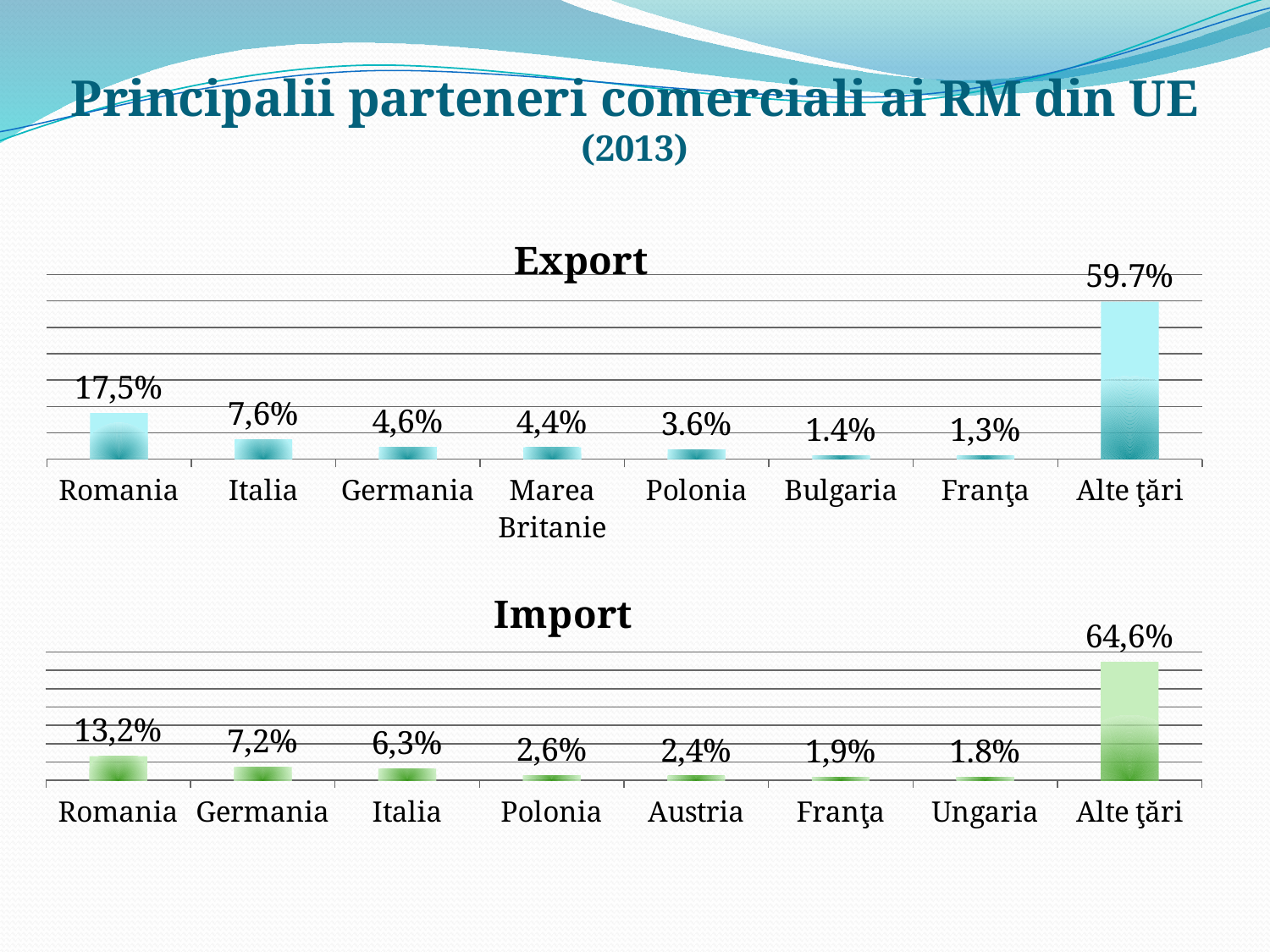
In the Import chart, what is the value for Ungaria? 1.8% In the Export chart, what is the difference between the values for Romania and Italia? 9,9% What kind of chart is the Export chart? Bar chart In the Import chart, which is larger, the value for Austria or the value for Franţa? Austria In the Import chart, what is the difference between the values for Italia and Polonia? 3,7% In the Export chart, what is the value for Alte ţări? 59.7% In the Export chart, what is the value for Polonia? 3.6% In the Import chart, which category has the lowest value? Ungaria In the Export chart, which named country (excluding Alte ţări) has the highest value? Romania In the Import chart, what is the value for Germania? 7,2% How many categories are shown in the Import chart? 8 In the Export chart, what is the value for Romania? 17,5%